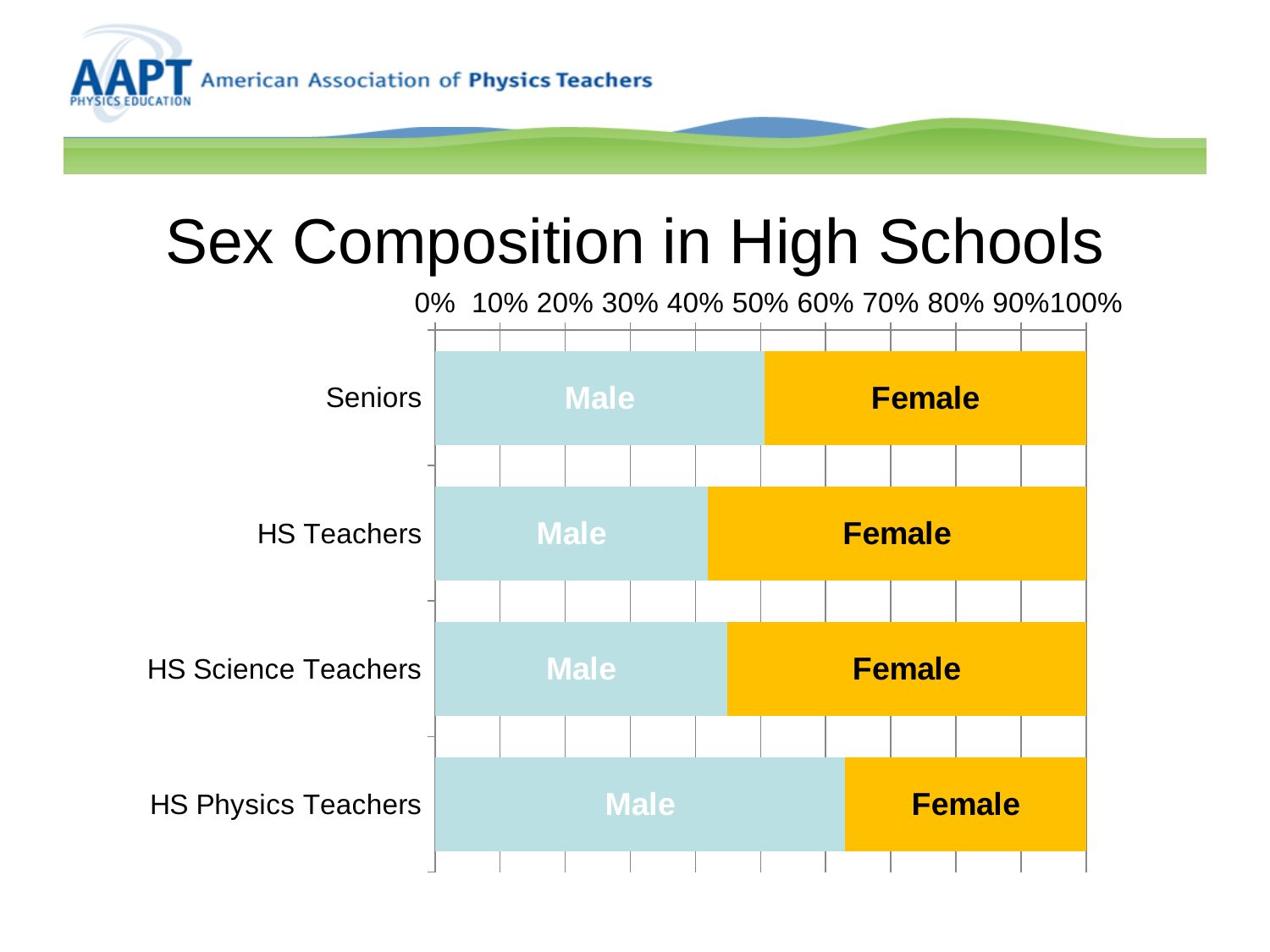
Which category has the largest Male share? HS Physics Teachers Is the Male share for HS Teachers greater or less than 50%? less What type of chart is shown on the slide? Stacked bar chart Is the Female share for HS Physics Teachers greater or less than 40%? less Which has a larger Male share, Seniors or HS Physics Teachers? HS Physics Teachers How many series (segments) make up each bar in the chart? 2 Is the Male share for HS Physics Teachers greater or less than 60%? greater Which category has the largest Female share? HS Teachers What colour represents the Female segment in the chart? Yellow Which has a larger Female share, HS Teachers or HS Physics Teachers? HS Teachers How many categories are shown on the chart? 4 What is the title of the chart? Sex Composition in High Schools